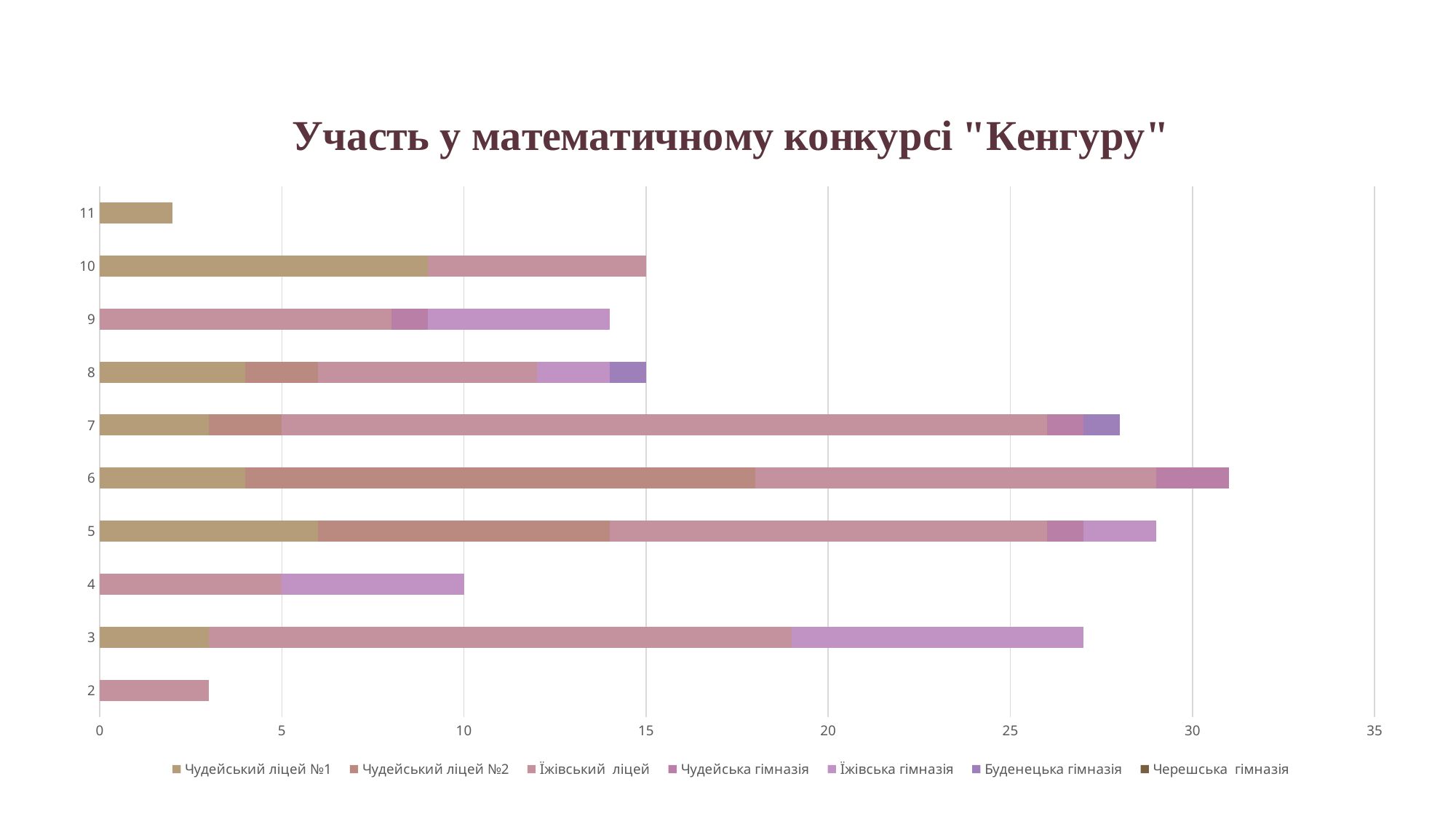
Is the total value for category 3 greater or less than 25? greater Is the total value for category 6 greater or less than 30? greater Is the total value for category 9 greater or less than 15? less How many categories (grades) are shown on the vertical axis? 10 How many series does the legend list? 7 What is the title of the chart? Участь у математичному конкурсі "Кенгуру" Which category has the longest total bar? 6 Which series is listed first in the legend? Чудейський ліцей №1 Which category has the shortest total bar? 11 Which has the larger total bar, category 3 or category 4? 3 What kind of chart is shown on the slide? stacked bar chart